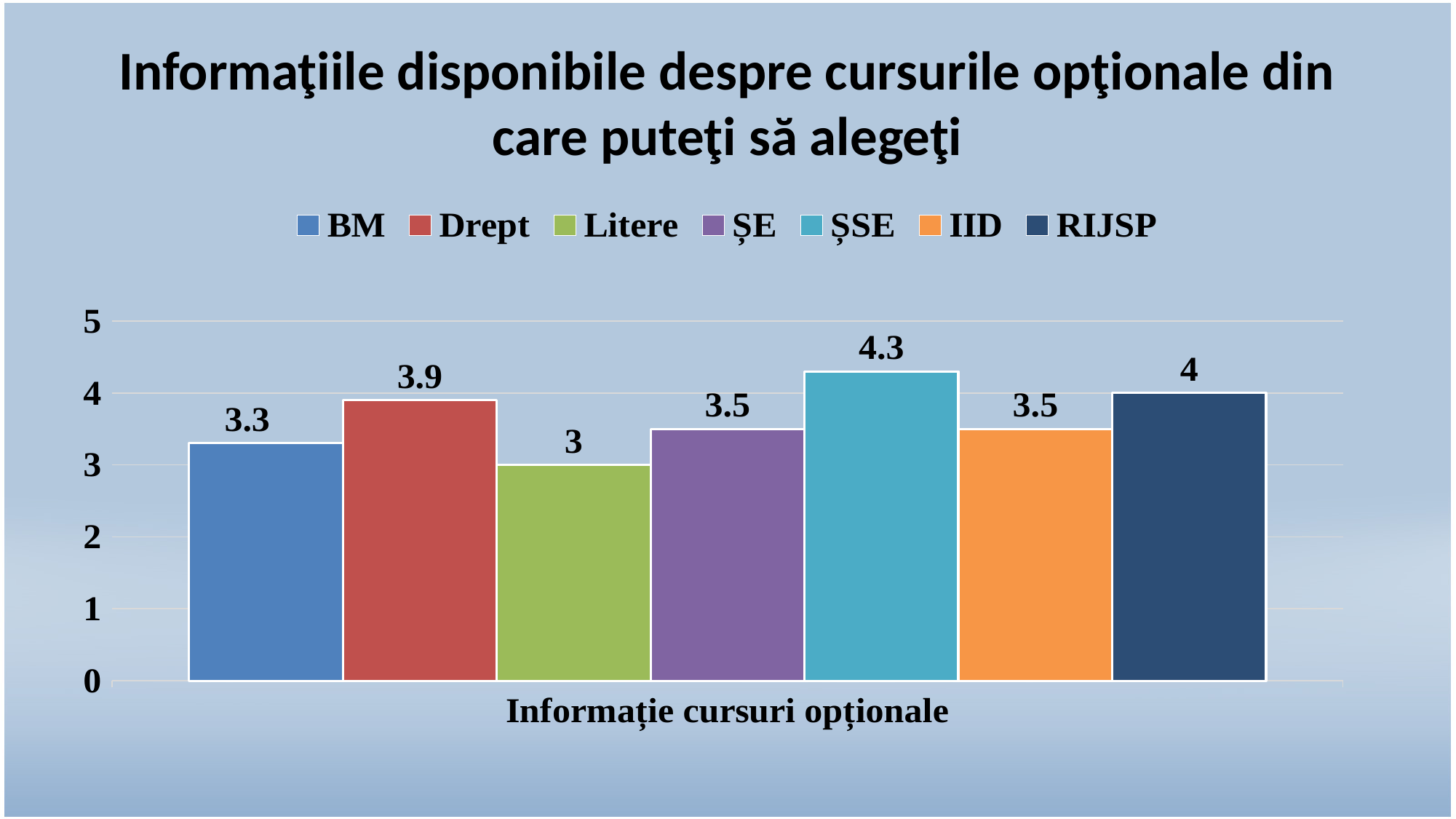
Which series has the highest value? ȘSE What is the x-axis label of the chart? Informație cursuri opționale What is the difference between the values for Drept and BM? 0.6 What kind of chart is shown on the slide? Bar chart What is the value for RIJSP? 4 What is the value for ȘSE? 4.3 Which series has the lowest value? Litere What is the difference between the values for ȘSE and Litere? 1.3 What is the value for Drept? 3.9 How many series does the legend list? 7 Which is larger, the value for RIJSP or the value for Drept? RIJSP What is the value for BM? 3.3